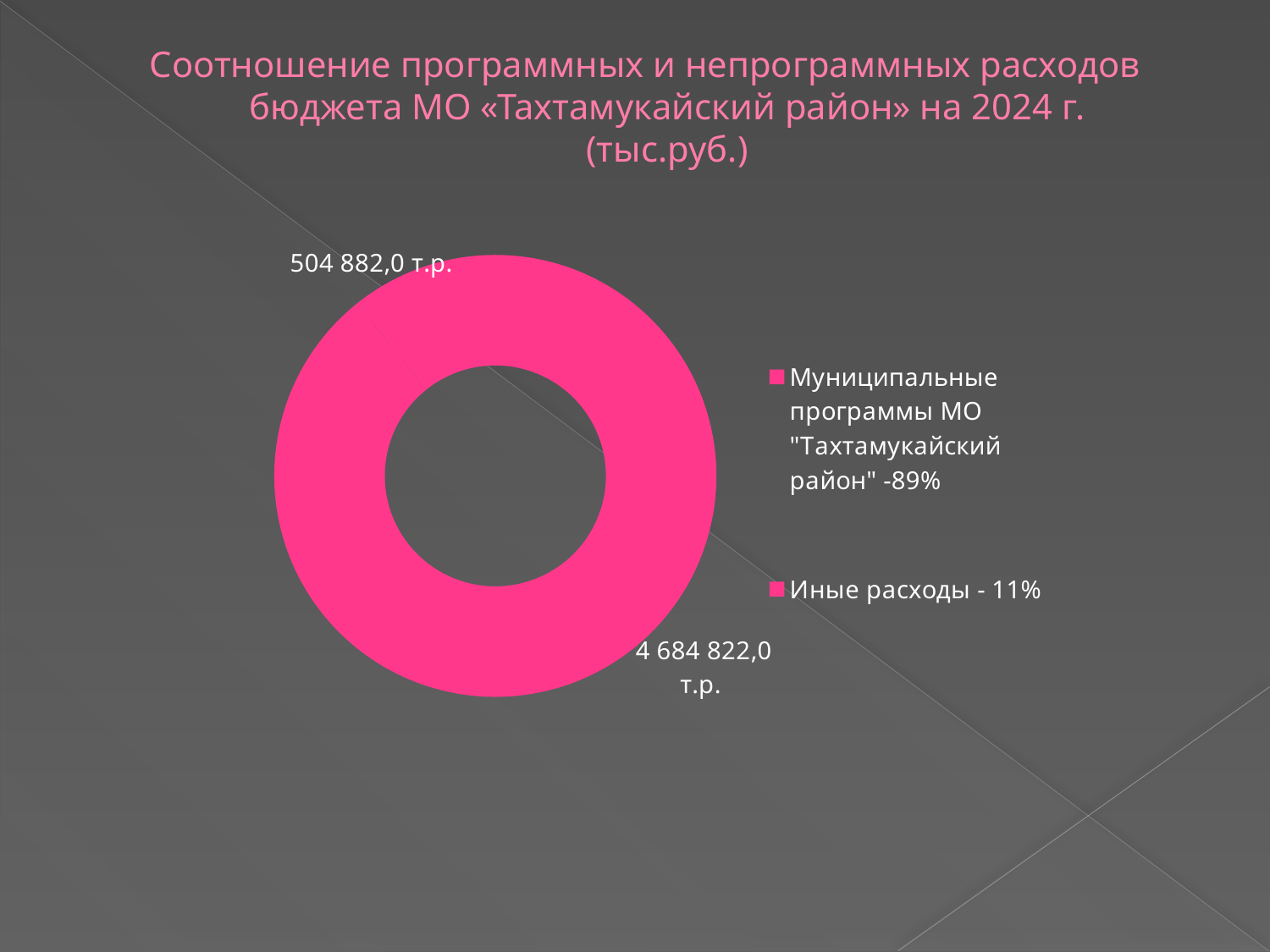
What is the value shown for Иные расходы? 504 882,0 т.р. How many entries does the legend list? 2 How many categories (slices) does the chart have? 2 What share of the budget expenditures is Иные расходы? 11% What kind of chart is shown on the slide? Doughnut (pie) chart What share of the budget expenditures goes to Муниципальные программы МО "Тахтамукайский район"? 89% What is the value shown for Муниципальные программы МО "Тахтамукайский район"? 4 684 822,0 т.р. What is the difference between the value for Муниципальные программы (4 684 822,0 т.р.) and Иные расходы (504 882,0 т.р.)? 4 179 940,0 т.р. Which category has the largest share of expenditures? Муниципальные программы МО "Тахтамукайский район" In what units are the values on the chart expressed, according to the title? тыс.руб. Which is larger: Муниципальные программы or Иные расходы? Муниципальные программы Which category has the smallest share of expenditures? Иные расходы